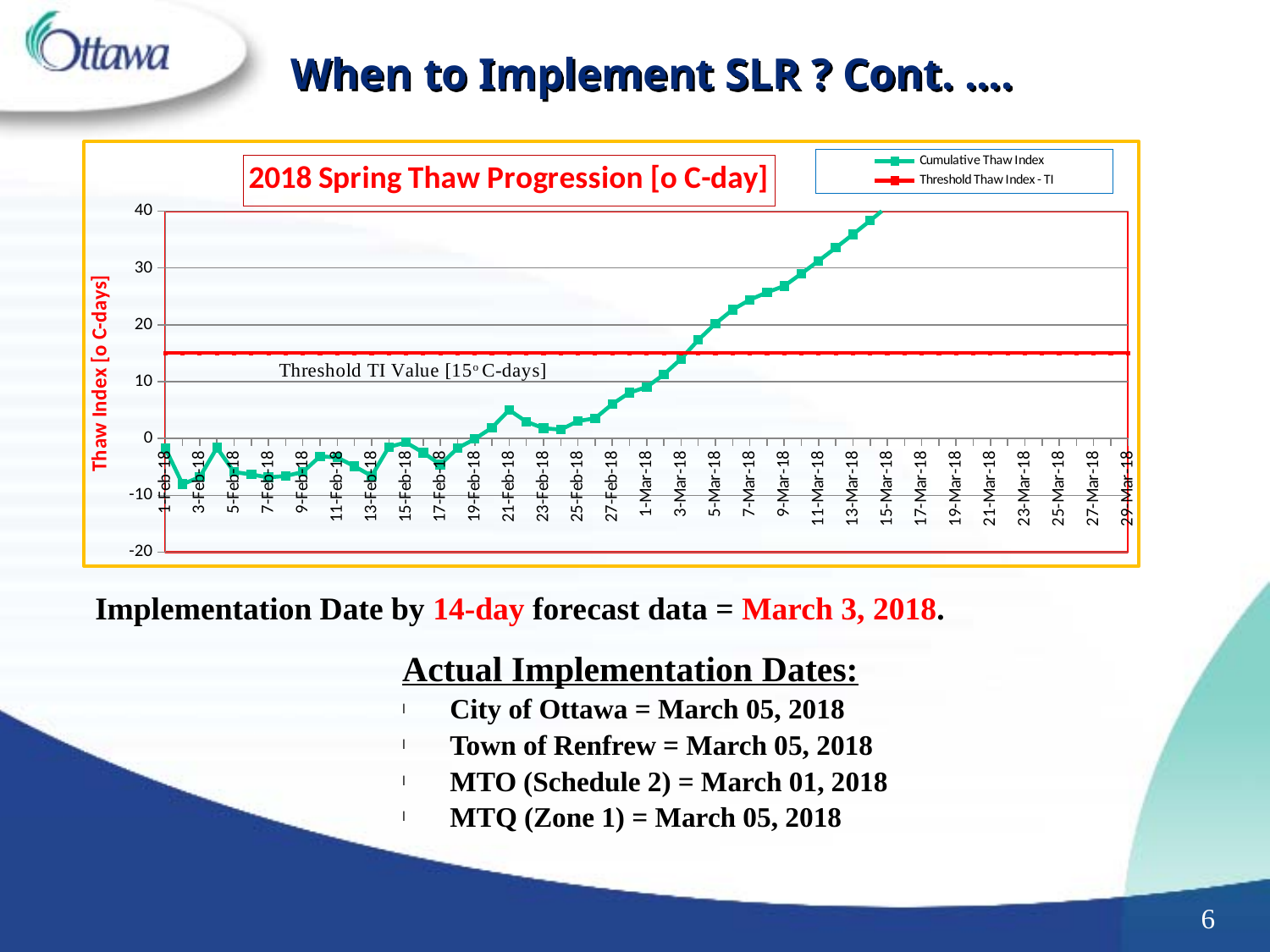
Is the Cumulative Thaw Index on 9-Mar-18 greater or less than 20? greater What colour is the Threshold Thaw Index - TI line in the chart? red What kind of chart is shown on the slide? line chart Does the Cumulative Thaw Index rise or fall between 1-Mar-18 and 15-Mar-18? rise Is the Cumulative Thaw Index on 3-Feb-18 greater or less than 0? less What is the title of the chart? 2018 Spring Thaw Progression [o C-day] How many series does the chart legend list? 2 Which date has the larger Cumulative Thaw Index, 21-Feb-18 or 3-Feb-18? 21-Feb-18 Is the Cumulative Thaw Index on 23-Feb-18 greater or less than 10? less What is the Threshold TI Value shown on the chart? 15